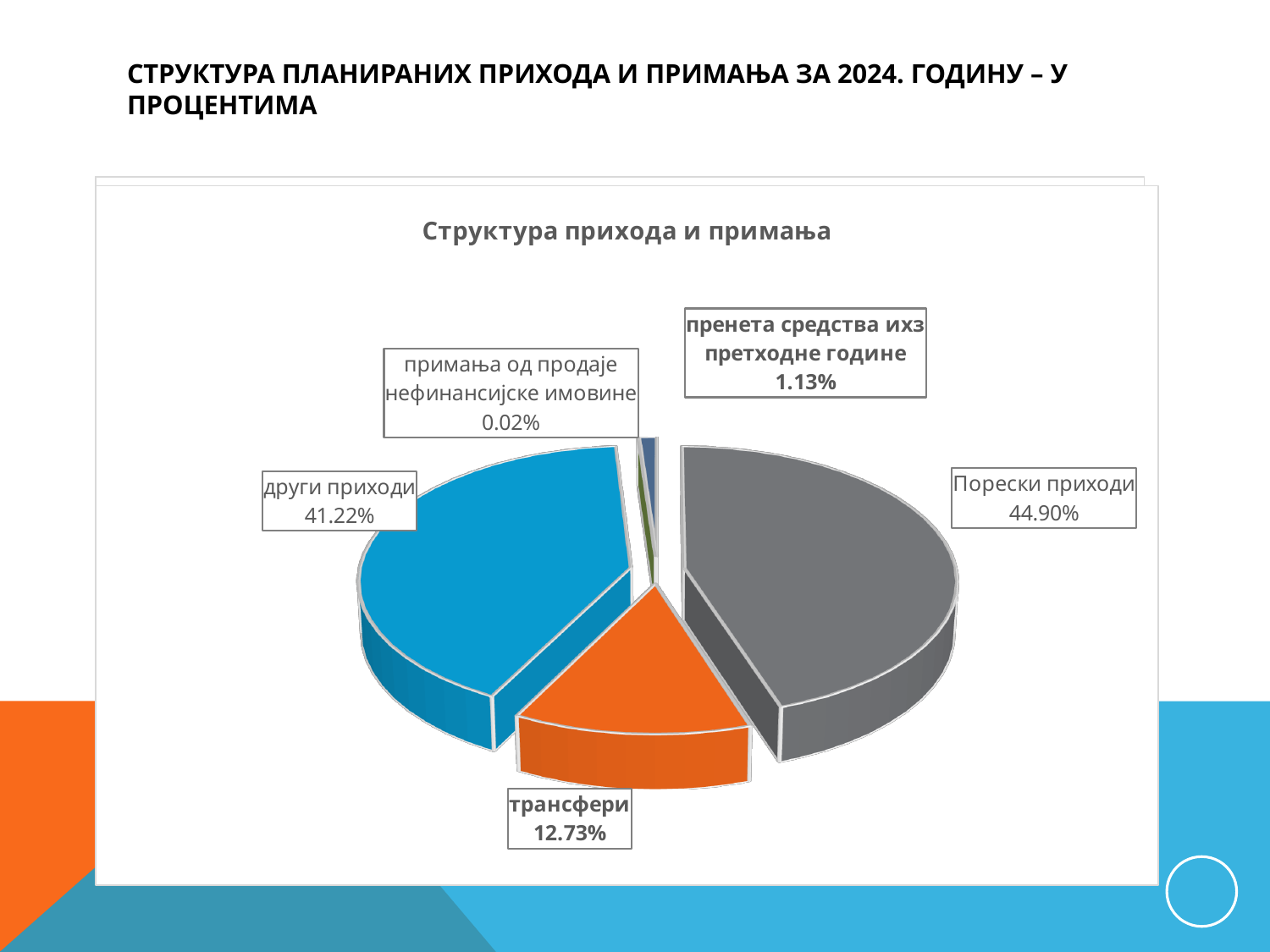
What share of the pie is labelled for други приходи? 41.22% What kind of chart is shown on the slide? Pie chart Which is larger, the share for трансфери or the share for пренета средства ихз претходне године? трансфери What share of the pie is labelled for примања од продаје нефинансијске имовине? 0.02% Which category has the smallest share of the pie? примања од продаје нефинансијске имовине Which category has the largest share of the pie? Порески приходи How many slices does the pie chart have? 5 What share of the pie is labelled for Порески приходи? 44.90% What is the difference between the shares of Порески приходи and други приходи? 3.68% What share of the pie is labelled for трансфери? 12.73% What is the title of the chart? Структура прихода и примања What share of the pie is labelled for пренета средства ихз претходне године? 1.13%